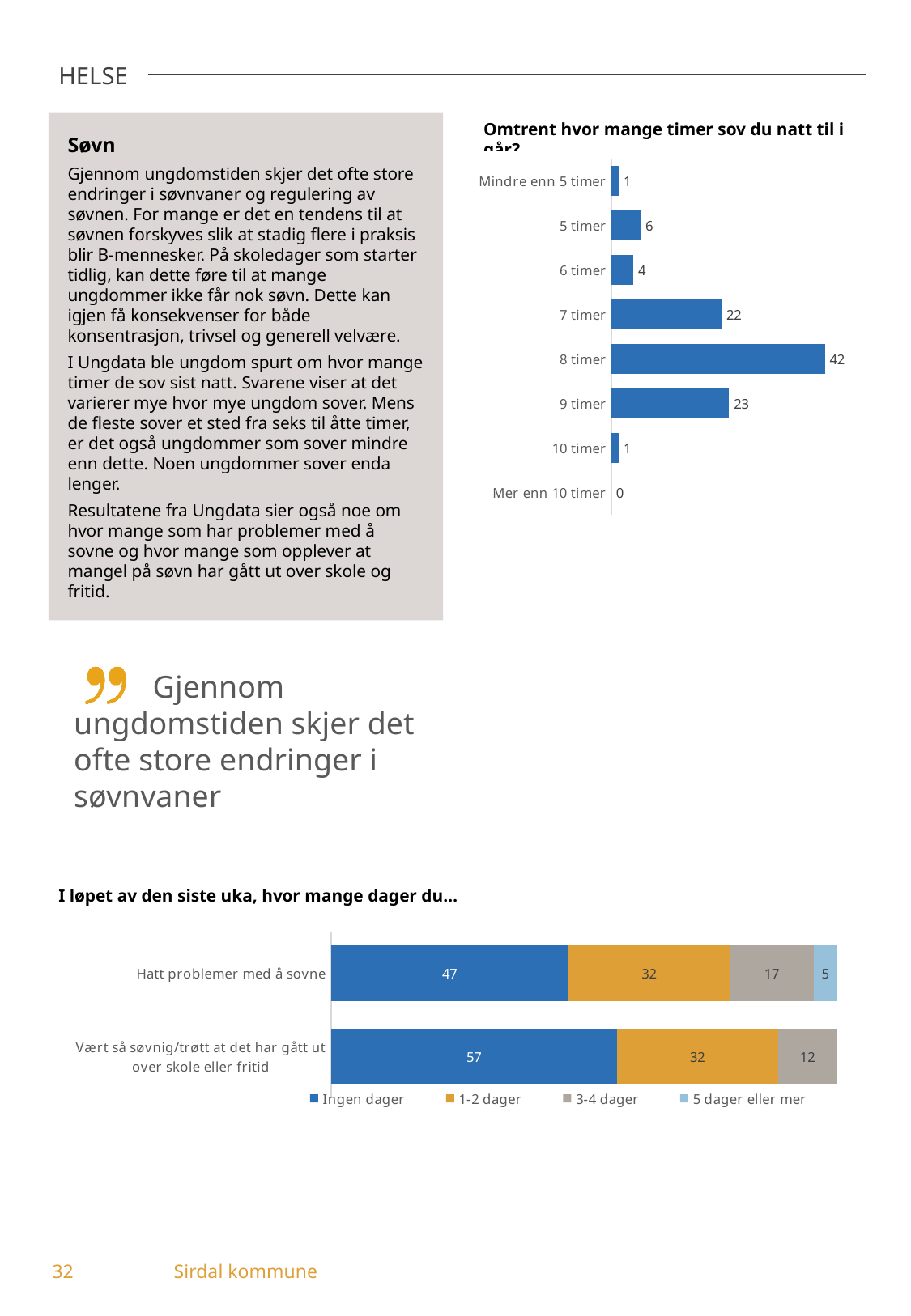
How many series does the legend of the bottom chart on the slide list? 4 How many categories are shown in the top chart on the slide? 8 In the top chart on the slide, what is the difference between the values for 9 timer and 7 timer? 1 In the top chart on the slide, which category has the lowest value? Mer enn 10 timer In the bottom chart on the slide, what is the value for Ingen dager in the bar 'Hatt problemer med å sovne'? 47 In the top chart on the slide, which category has the highest value? 8 timer In the top chart on the slide, what is the value for 8 timer? 42 In the top chart on the slide, what is the value for 7 timer? 22 In the bottom chart on the slide, what is the total of the bar 'Hatt problemer med å sovne'? 101 In the top chart on the slide, which is larger, the value for 5 timer or the value for 6 timer? 5 timer What kind of chart is the top chart on the slide? Bar chart In the bottom chart on the slide, what is the value for 3-4 dager in the bar 'Vært så søvnig/trøtt at det har gått ut over skole eller fritid'? 12